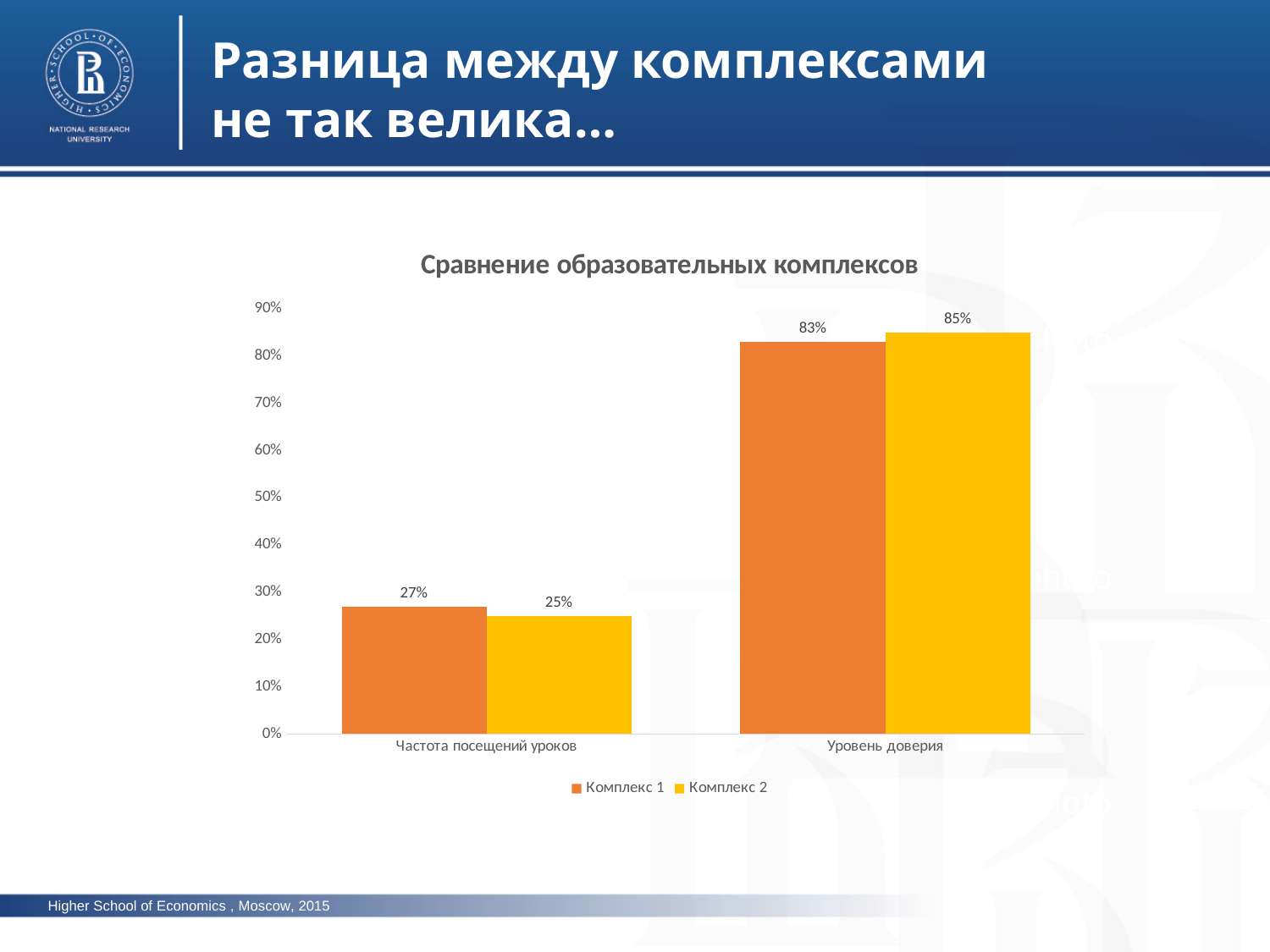
Which series has the higher value in the Частота посещений уроков category? Комплекс 1 What is the value for Комплекс 2 in the Уровень доверия category? 85% Which series has the higher value in the Уровень доверия category? Комплекс 2 What is the value for Комплекс 2 in the Частота посещений уроков category? 25% How many categories are shown on the x axis? 2 What is the value for Комплекс 1 in the Частота посещений уроков category? 27% What is the value for Комплекс 1 in the Уровень доверия category? 83% What is the difference between Комплекс 2 and Комплекс 1 in the Уровень доверия category? 2% How many series does the legend list? 2 What kind of chart is shown on the slide? Bar chart What is the difference between Комплекс 1 and Комплекс 2 in the Частота посещений уроков category? 2% What is the title of the chart? Сравнение образовательных комплексов